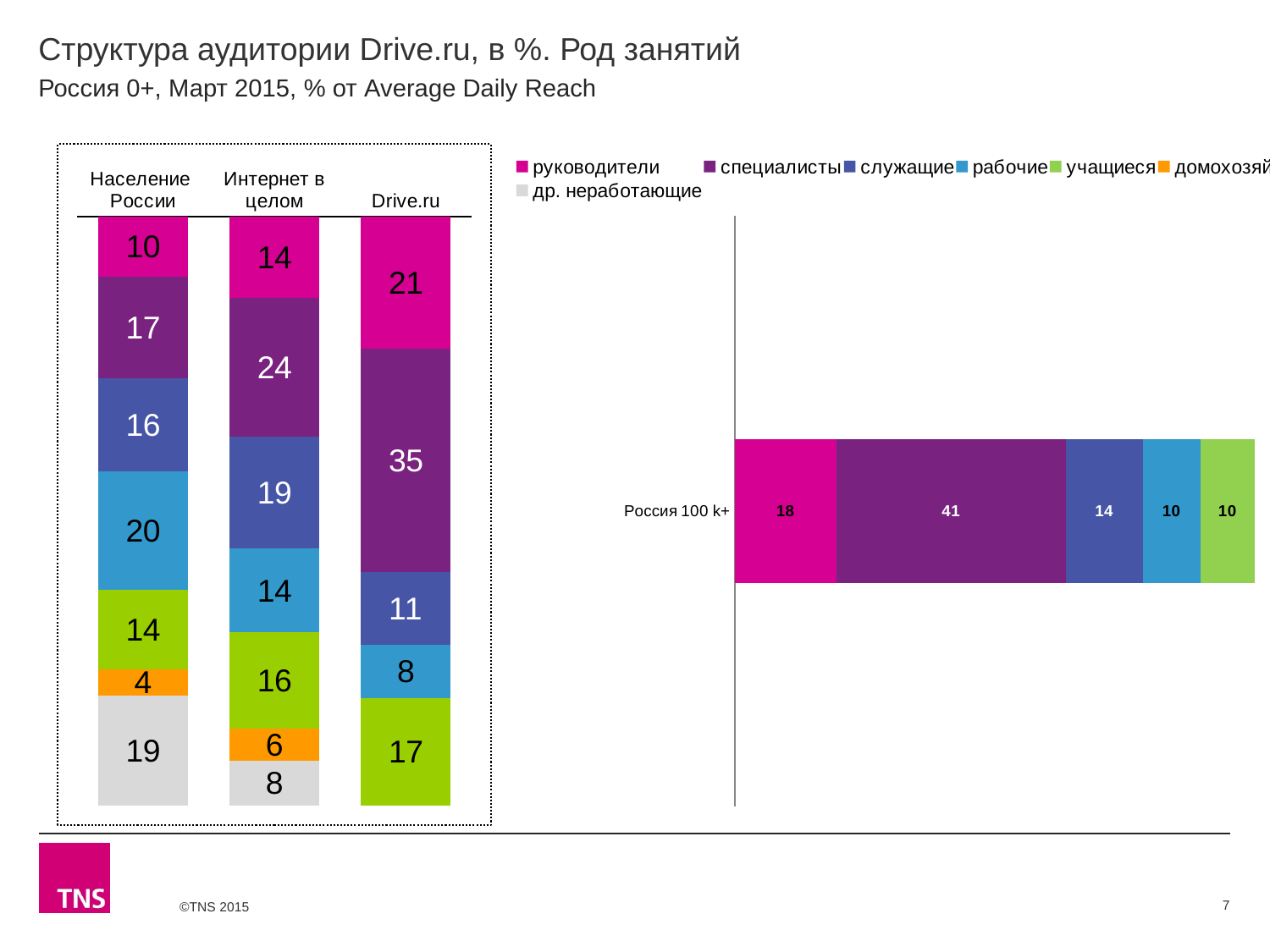
In the left chart, is the служащие value larger for Интернет в целом or for Drive.ru? Интернет в целом What type of chart is the right chart? Stacked bar chart In the left chart, what is the difference between the руководители values for Drive.ru and Население России? 11 In the right chart, what is the value of the специалисты segment for Россия 100 k+? 41 In the left chart, what is the value of the учащиеся segment for Интернет в целом? 16 In the left chart, which bar has the largest специалисты segment? Drive.ru In the left chart, what is the value of the специалисты segment for Drive.ru? 35 In the left chart, what is the value of the руководители segment for Население России? 10 In the left chart, what is the total of the Drive.ru bar? 92 In the left chart, which bar has the smallest рабочие segment? Drive.ru How many bars are shown in the left chart? 3 In the right chart, what is the total of the Россия 100 k+ bar? 93